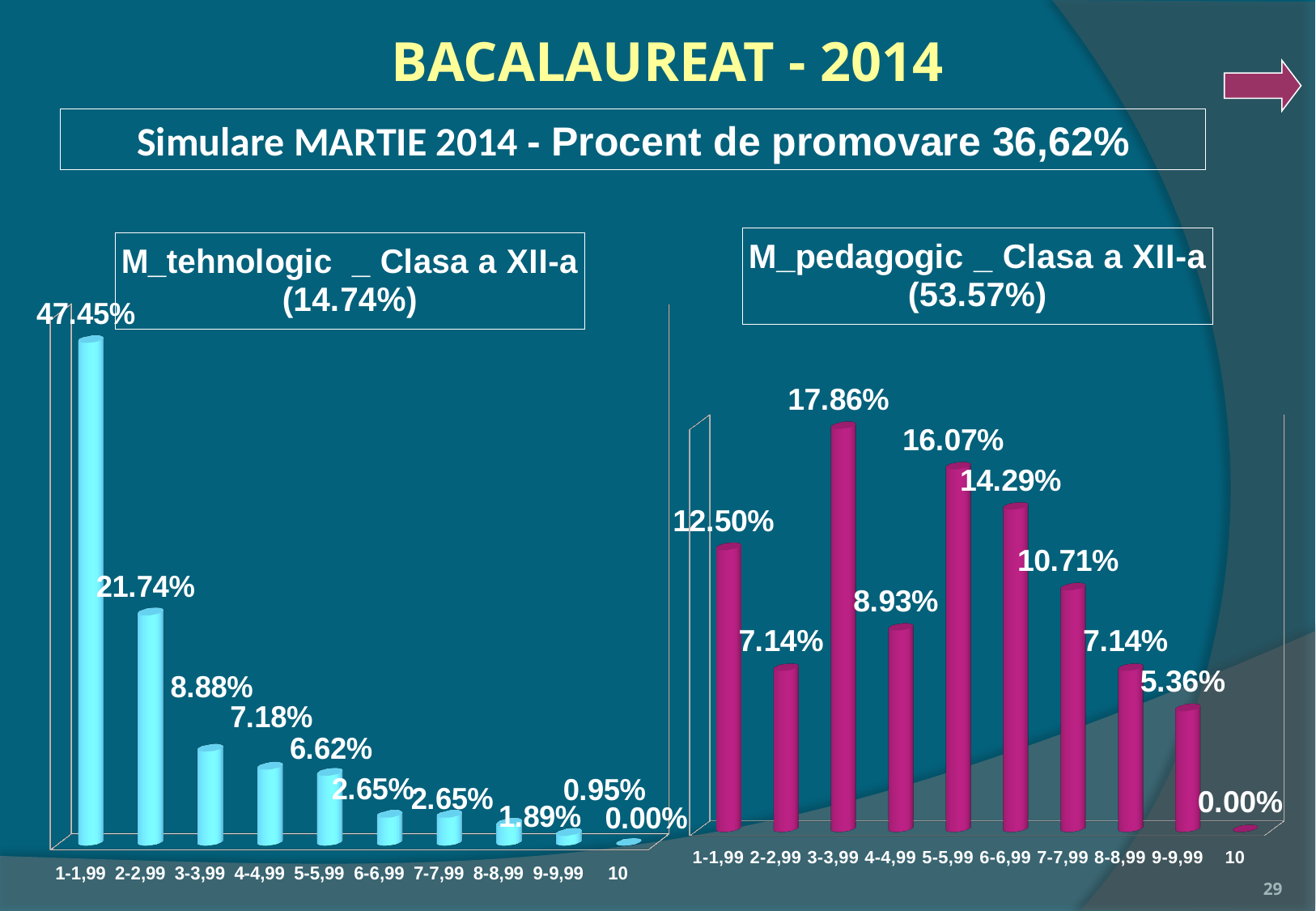
In the M_tehnologic chart, what is the value for the 3-3,99 category? 8.88% How many categories are shown on the x axis of the M_tehnologic chart? 10 In the M_pedagogic chart, what is the value for the 9-9,99 category? 5.36% In the M_pedagogic chart, what is the difference between the values for 3-3,99 and 4-4,99? 8.93% In the M_pedagogic chart, which category has the highest value? 3-3,99 In the M_tehnologic chart, do the values generally rise or fall from left to right along the x axis? Fall In the M_pedagogic chart, what is the value for the 5-5,99 category? 16.07% What kind of chart is the M_pedagogic chart? Bar chart In the M_tehnologic chart, which category has the lowest value? 10 In the M_tehnologic chart, what is the difference between the values for 1-1,99 and 2-2,99? 25.71% In the M_tehnologic chart, what is the value for the 1-1,99 category? 47.45% In the M_pedagogic chart, which is larger: the value for 1-1,99 or the value for 7-7,99? 1-1,99